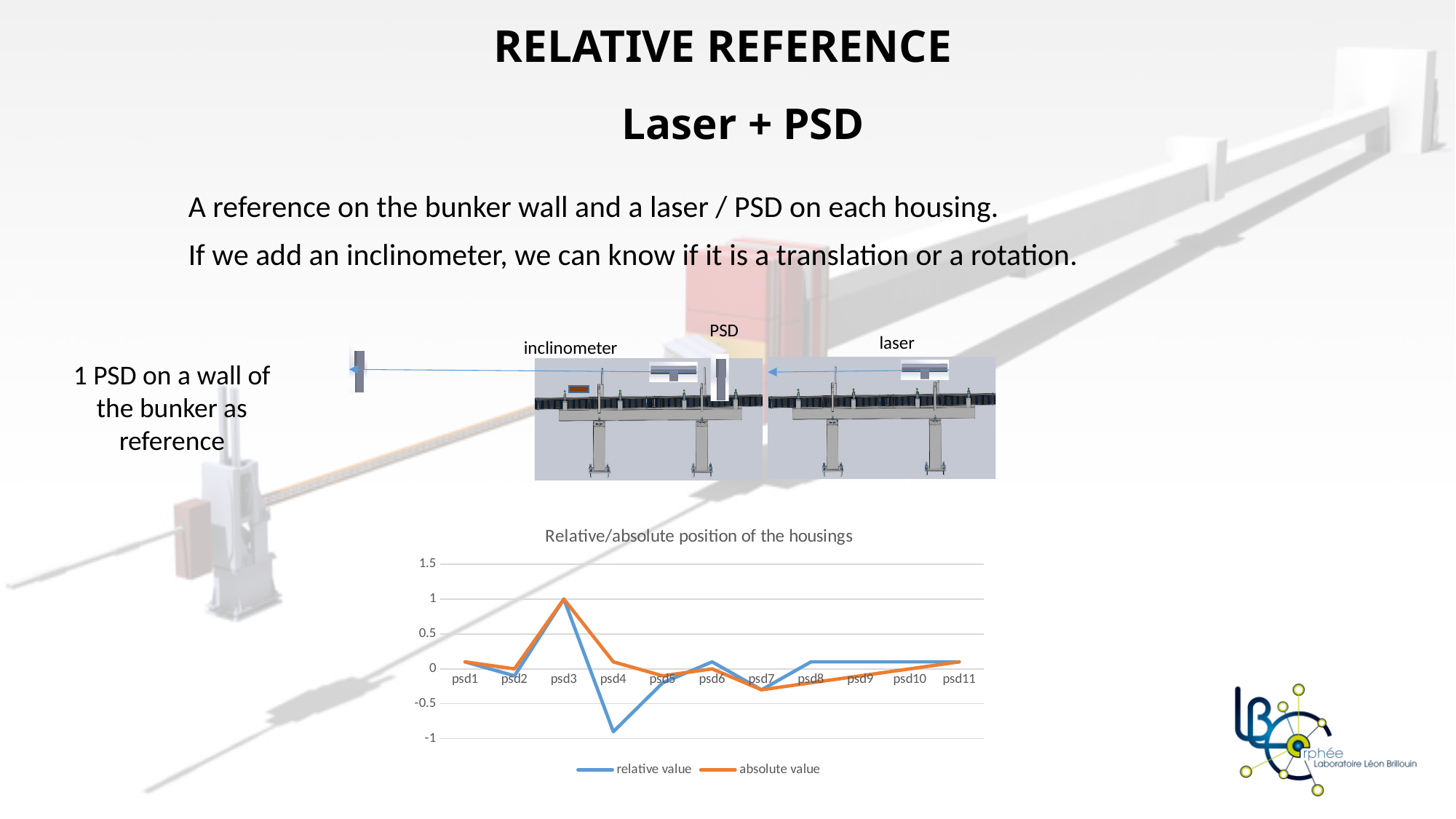
At which PSD does the relative value series reach its lowest point? psd4 How many series does the chart legend list? 2 How many PSD categories are plotted along the x axis of the chart? 11 Is the absolute value at psd3 greater or less than 0.5? greater Is the relative value at psd4 greater or less than -0.5? less What is the title of the chart? Relative/absolute position of the housings Is the absolute value at psd7 greater or less than 0? less Which series in the chart is drawn in orange? absolute value At psd4, which series has the larger value, relative value or absolute value? absolute value At which PSD does the relative value series reach its highest point? psd3 At which PSD does the absolute value series reach its highest point? psd3 What kind of chart is shown on the slide? line chart